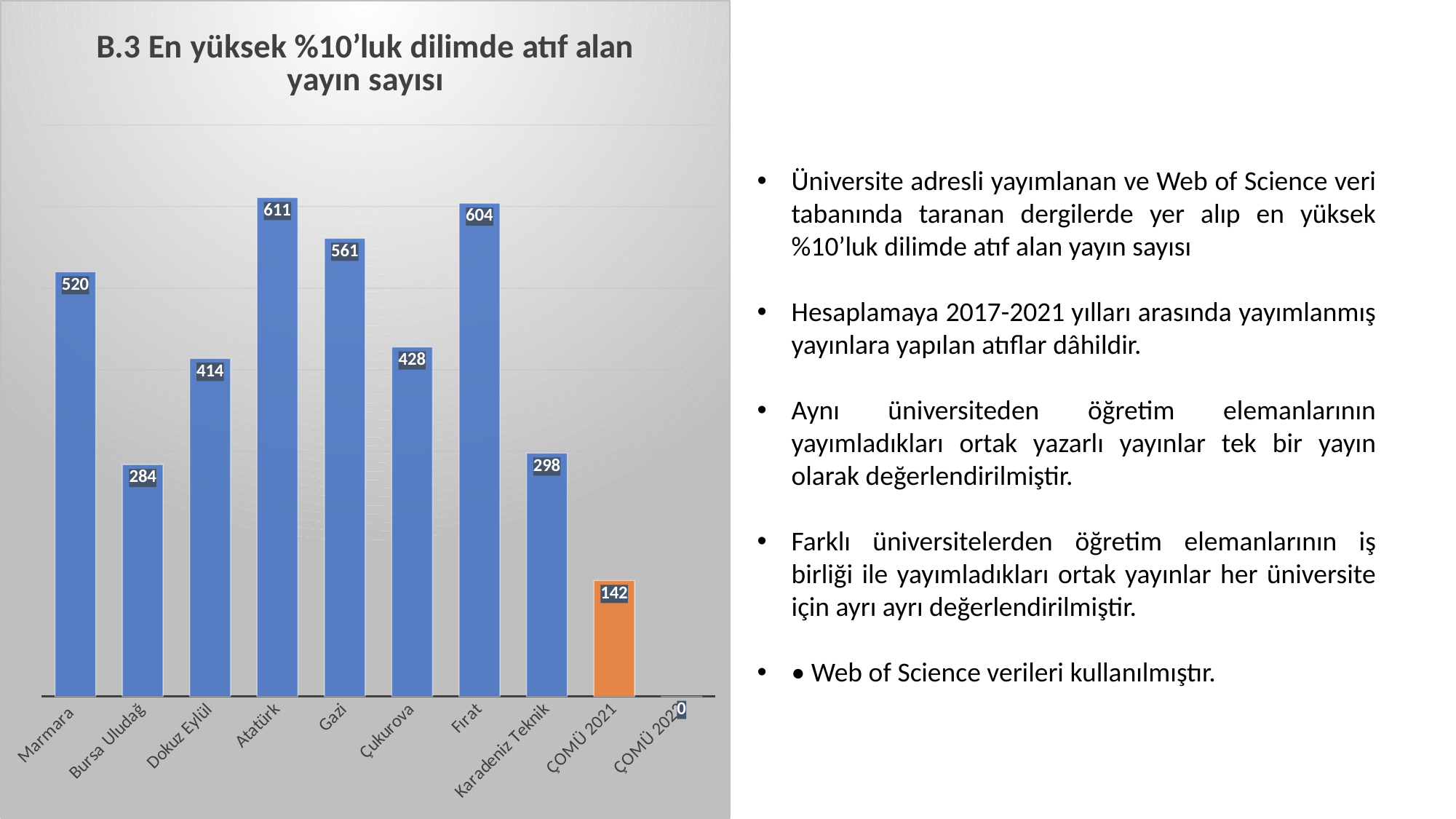
What is the value for Karadeniz Teknik? 298 What is the difference between the values for Fırat and Karadeniz Teknik? 306 Which university has the highest value? Atatürk What is the difference between the values for Atatürk and Fırat? 7 What is the value for Gazi? 561 Which bar is coloured orange instead of blue? ÇOMÜ 2021 What is the value for ÇOMÜ 2021? 142 What is the difference between the values for Marmara and Bursa Uludağ? 236 What kind of chart is shown on the slide? Bar chart Which has a larger value, Gazi or Çukurova? Gazi What is the value for Marmara? 520 How many bars are shown in the chart? 9